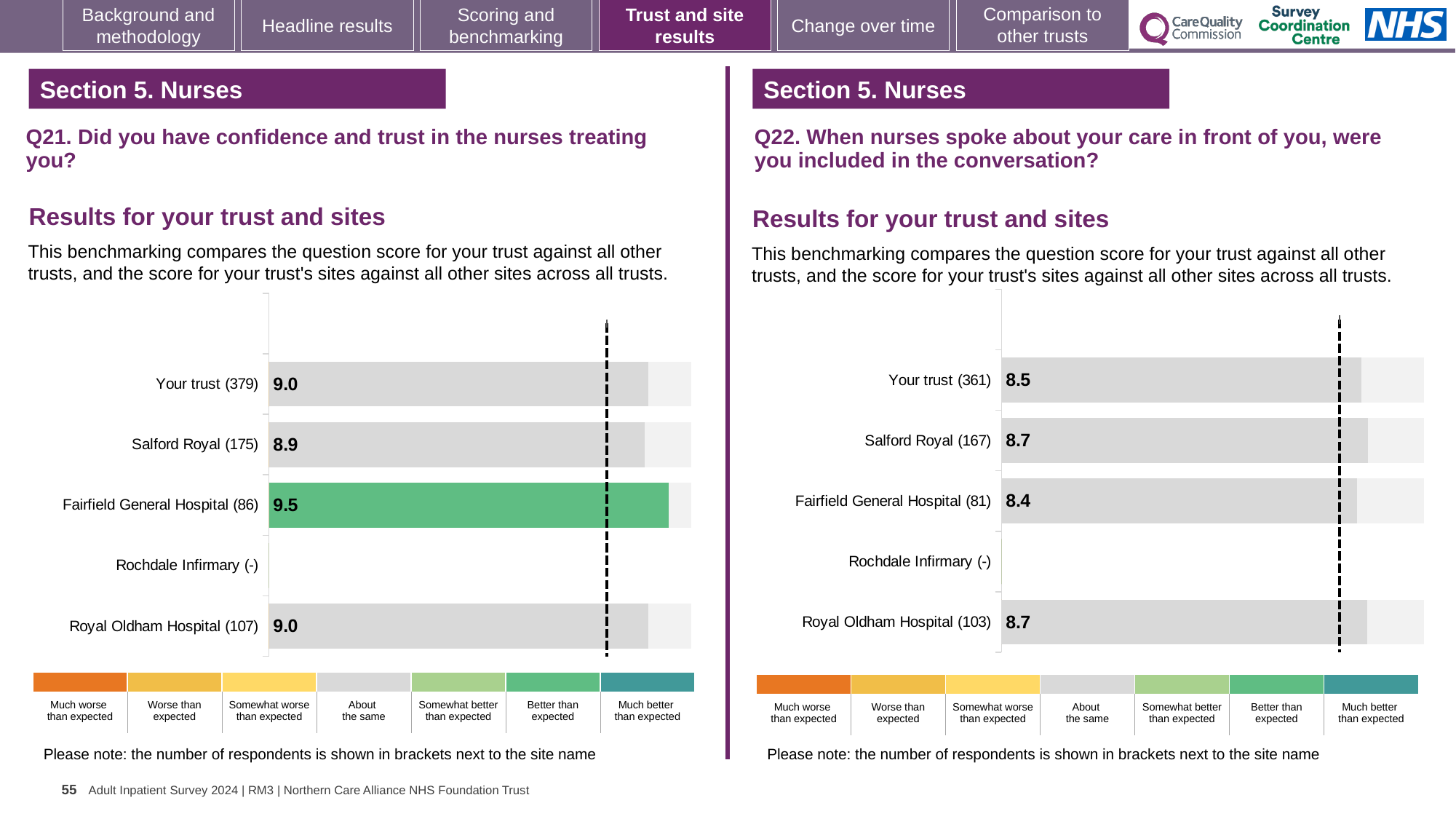
On the Q22 chart (right), what is the difference between the scores for Royal Oldham Hospital and Your trust? 0.2 On the Q21 chart (left), what is the score for Salford Royal? 8.9 On the Q21 chart (left), what is the difference between the scores for Fairfield General Hospital and Salford Royal? 0.6 On the Q22 chart (right), which is larger: the score for Salford Royal or the score for Your trust? Salford Royal What type of chart is used on the Q21 chart (left)? Bar chart On the Q22 chart (right), what is the score for Fairfield General Hospital? 8.4 On the Q21 chart (left), which site has the highest score? Fairfield General Hospital On the Q21 chart (left), what is the score for Fairfield General Hospital? 9.5 On the Q22 chart (right), what is the score for Your trust? 8.5 On the Q21 chart (left), how many respondents are shown for Your trust? 379 On the Q22 chart (right), which site has the lowest score among those with a value shown? Fairfield General Hospital How many site/trust rows are listed on the Q21 chart (left)? 5